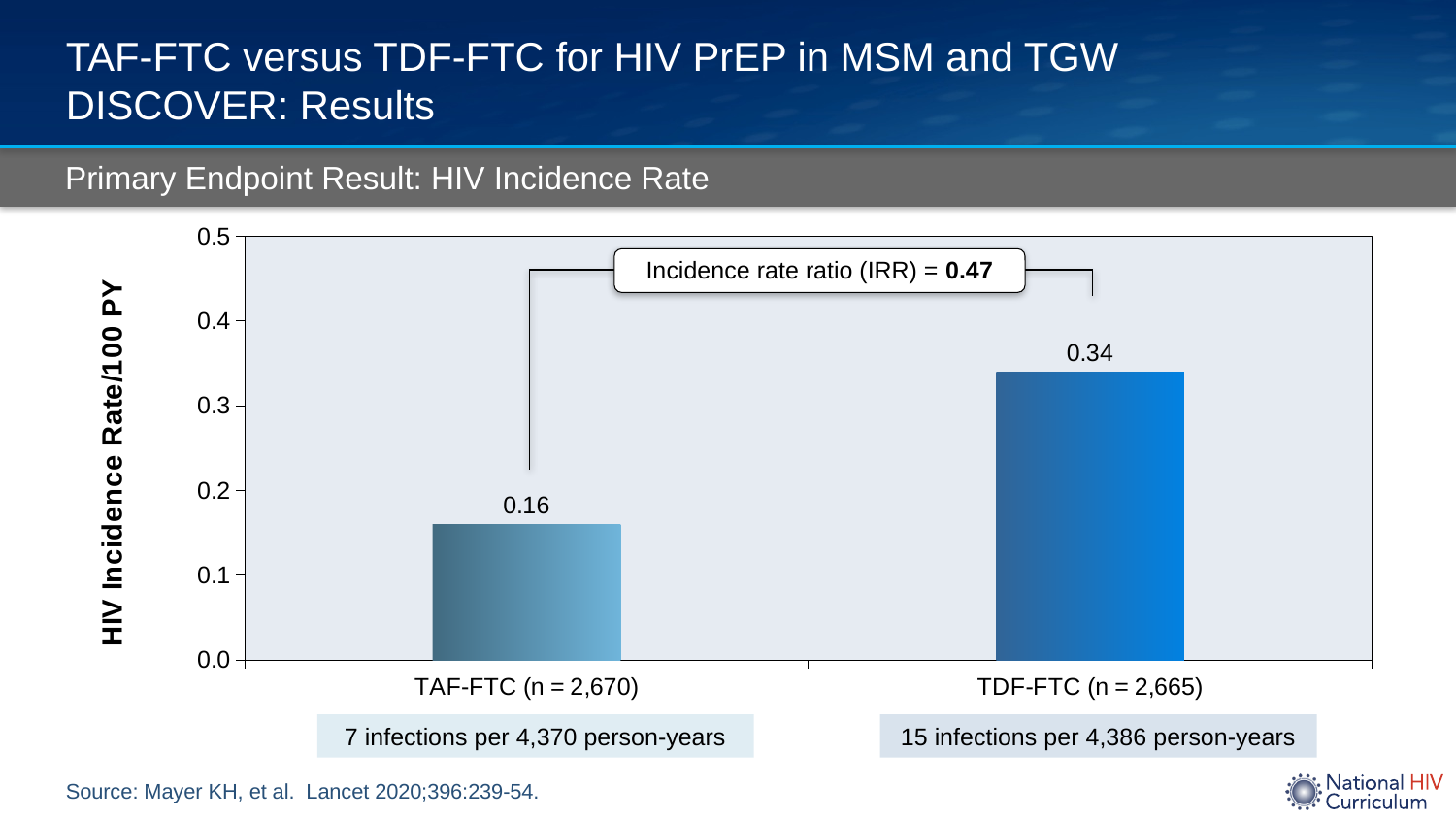
What is the label of the y-axis? HIV Incidence Rate/100 PY What is the HIV incidence rate per 100 person-years for TDF-FTC? 0.34 What is the incidence rate ratio (IRR) shown on the chart? 0.47 Is the HIV incidence rate for TAF-FTC greater or less than 0.2? less What is the difference in HIV incidence rate between TDF-FTC and TAF-FTC? 0.18 How many groups are shown in the chart? 2 What is the HIV incidence rate per 100 person-years for TAF-FTC? 0.16 What type of chart is shown on the slide? Bar chart Which group has the higher HIV incidence rate? TDF-FTC Is the HIV incidence rate higher for TAF-FTC or TDF-FTC? TDF-FTC Which group has the lower HIV incidence rate? TAF-FTC Is the HIV incidence rate for TDF-FTC greater or less than 0.3? greater